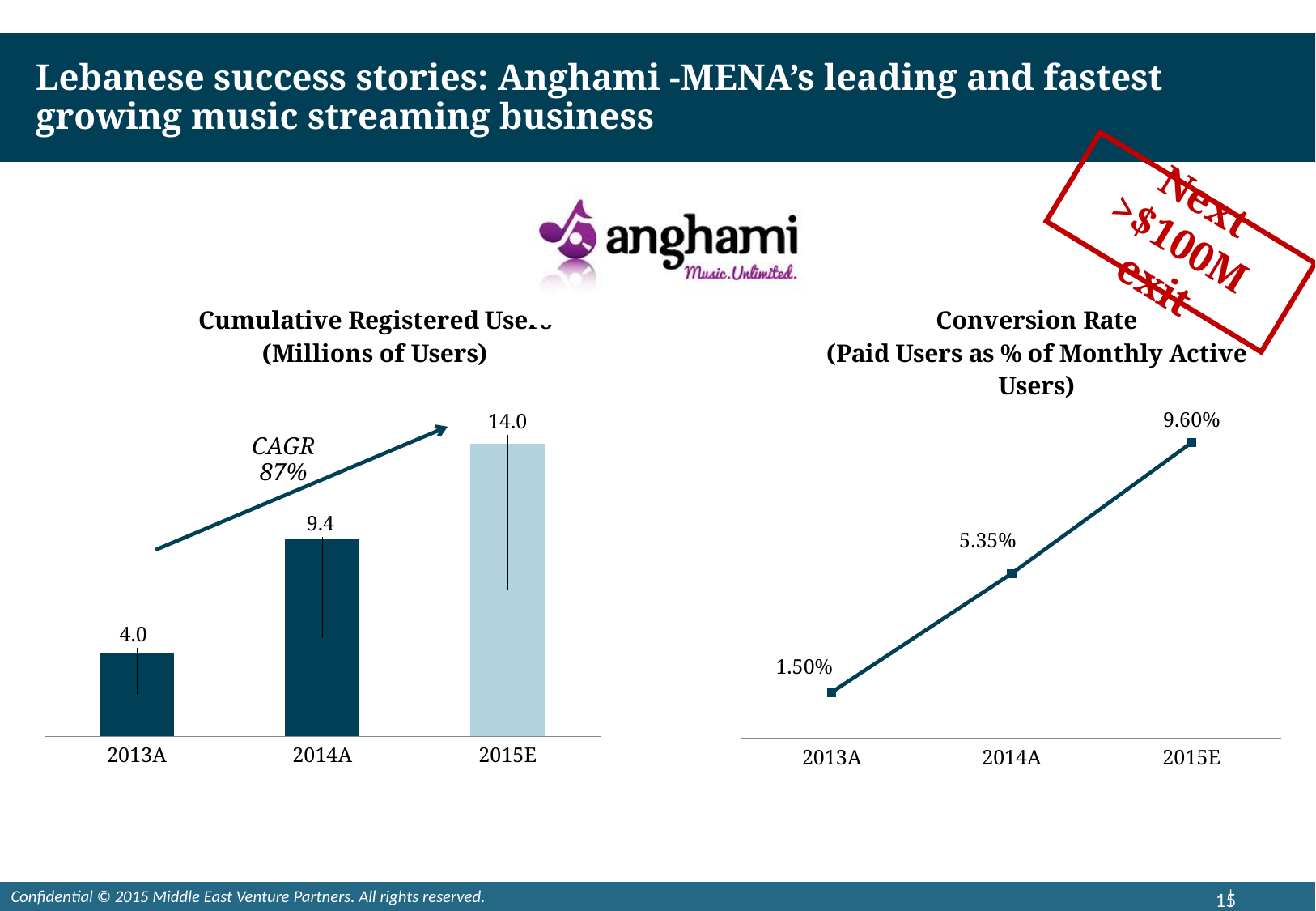
In the Conversion Rate chart, do the values rise or fall from 2013A to 2015E? Rise In the Conversion Rate chart, what is the value for 2013A? 1.50% In the Cumulative Registered Users chart, what is the difference between the 2015E and 2013A values? 10.0 In the Cumulative Registered Users chart, what kind of chart is shown? Bar chart In the Conversion Rate chart, what is the value for 2014A? 5.35% In the Cumulative Registered Users chart, what is the value for 2015E? 14.0 In the Conversion Rate chart, how many data points are plotted? 3 In the Cumulative Registered Users chart, what CAGR is annotated on the chart? 87% In the Conversion Rate chart, what kind of chart is shown? Line chart In the Cumulative Registered Users chart, which year has the lowest value? 2013A In the Cumulative Registered Users chart, what is the value for 2014A? 9.4 In the Conversion Rate chart, which year has the highest value? 2015E